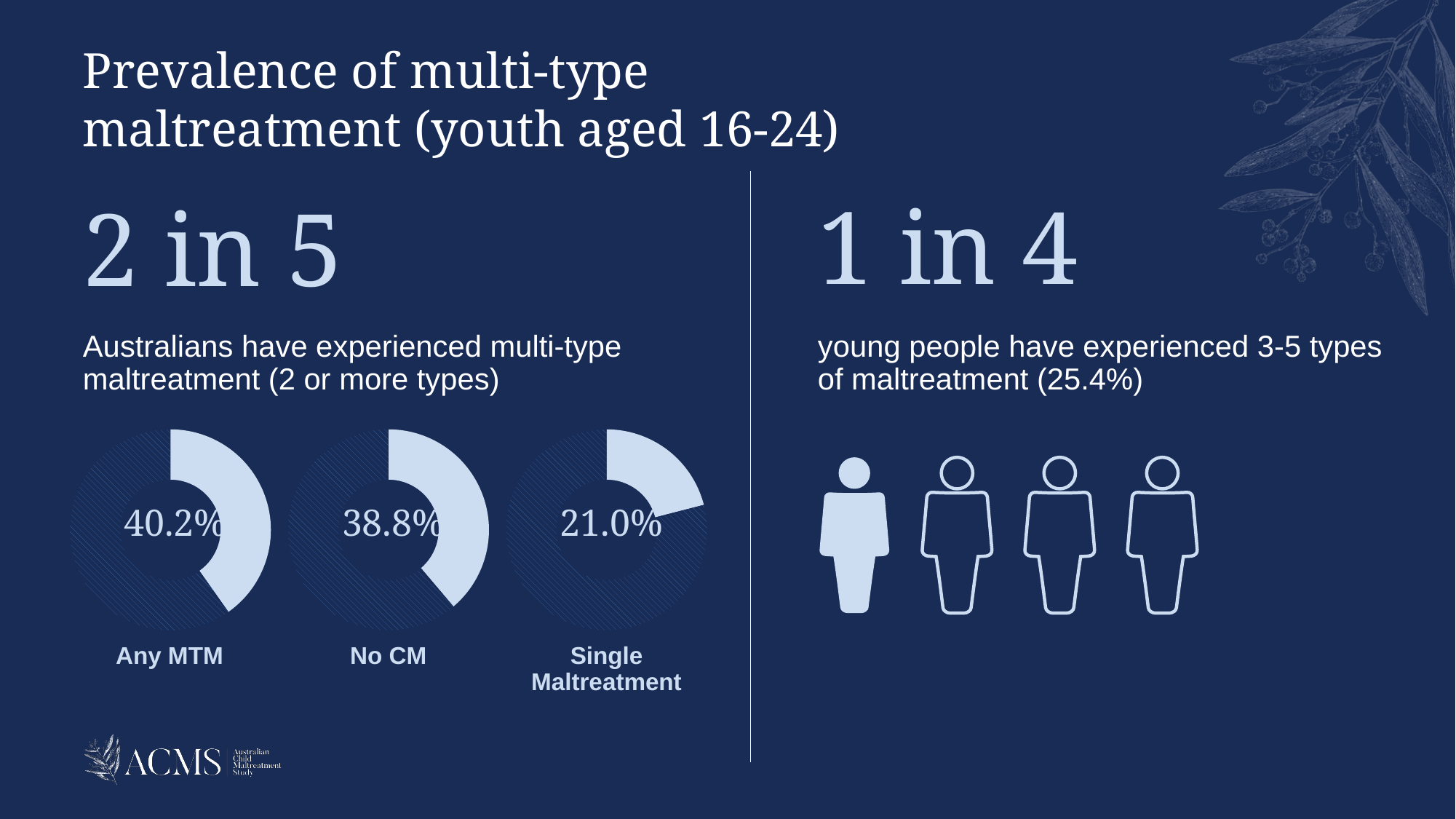
In the donut charts, which is larger: the value for No CM or the value for Single Maltreatment? No CM How many donut charts are shown on the left side of the slide? 3 What percentage is given for young people who have experienced 3-5 types of maltreatment in the right-hand pictogram section? 25.4% What is the difference between the Any MTM value and the Single Maltreatment value in the donut charts? 19.2 percentage points Among the three donut charts, which category has the highest value? Any MTM What kind of chart is used to show the Any MTM, No CM and Single Maltreatment values? Donut chart What value is shown in the donut chart labelled Any MTM? 40.2% Among the three donut charts, which category has the lowest value? Single Maltreatment What value is shown in the donut chart labelled No CM? 38.8% What is the difference between the Any MTM value and the No CM value in the donut charts? 1.4 percentage points What value is shown in the donut chart labelled Single Maltreatment? 21.0% In the pictogram on the right side of the slide, how many person icons are shown in total? 4